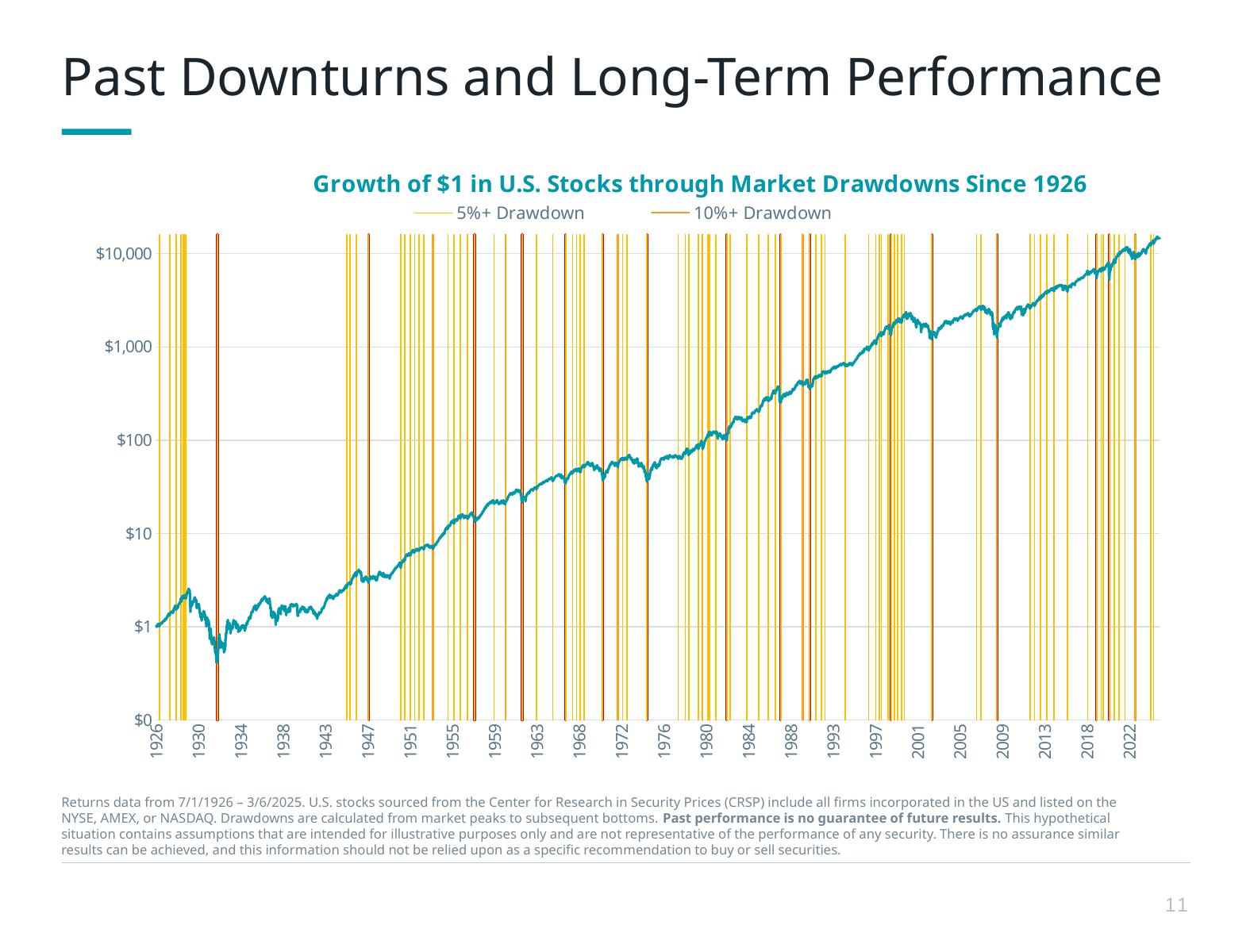
What kind of chart is shown on the slide? line chart Overall, does the growth line rise or fall from 1926 to the end of the chart? rise Is the value of the growth line in 1984 greater or less than $100? greater Is the value of the growth line in 1963 greater or less than $10? greater Is the value of the growth line at the end of the chart (2025) greater or less than $10,000? greater What are the two legend entries on the chart? 5%+ Drawdown and 10%+ Drawdown How many entries does the chart's legend list? 2 What is the title of the chart? Growth of $1 in U.S. Stocks through Market Drawdowns Since 1926